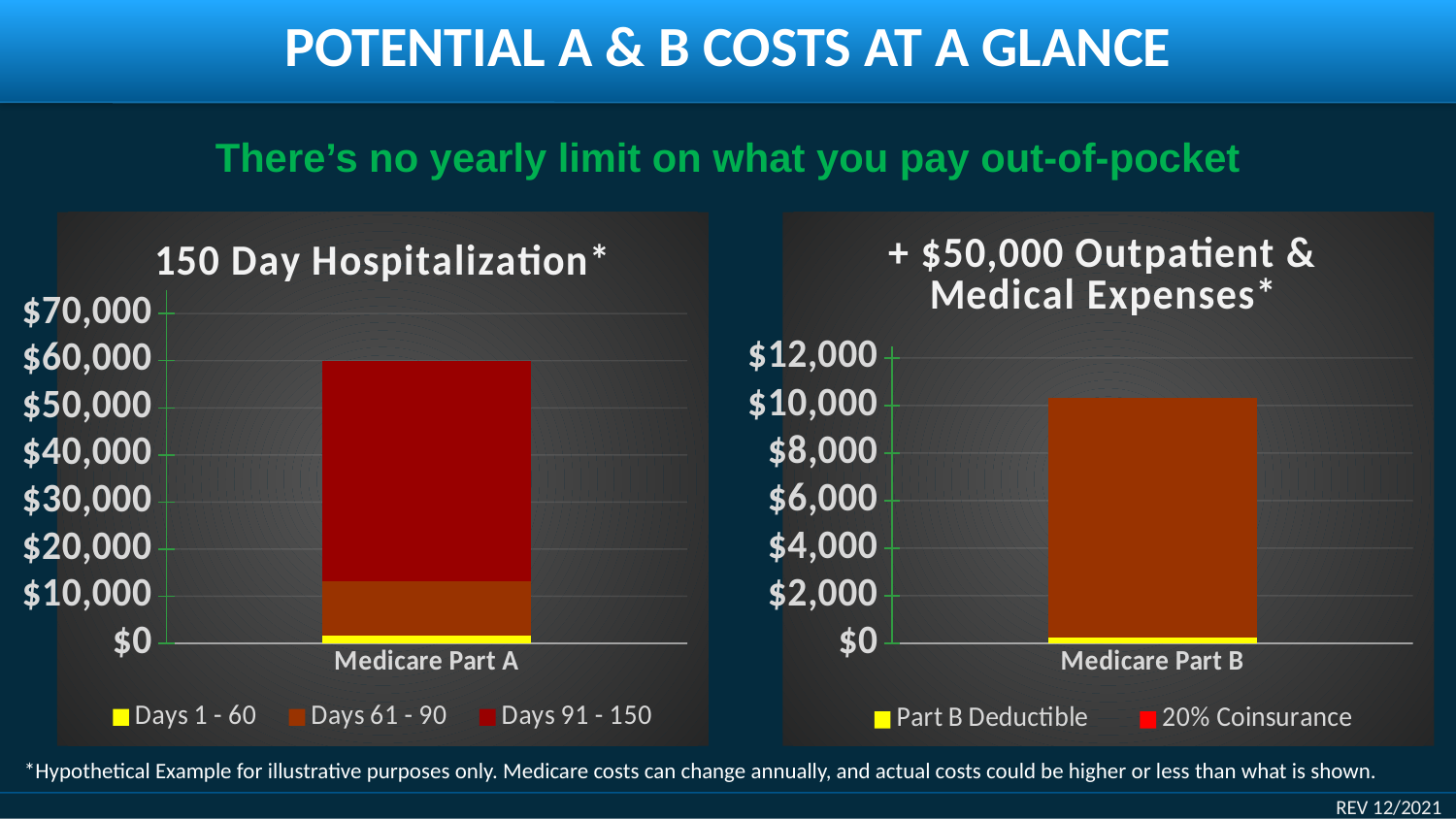
What kind of chart is the "+ $50,000 Outpatient & Medical Expenses*" chart? Stacked bar chart In the "150 Day Hospitalization*" chart, is the total height of the Medicare Part A bar greater or less than $50,000? greater What kind of chart is the "150 Day Hospitalization*" chart? Stacked bar chart In the "150 Day Hospitalization*" chart, is the Days 1 - 60 segment greater or less than $10,000? less In the "150 Day Hospitalization*" chart, which segment is larger, Days 91 - 150 or Days 61 - 90? Days 91 - 150 How many series does the legend of the "+ $50,000 Outpatient & Medical Expenses*" chart list? 2 In the "+ $50,000 Outpatient & Medical Expenses*" chart, is the 20% Coinsurance segment greater or less than $8,000? greater In the "+ $50,000 Outpatient & Medical Expenses*" chart, what is the label of the category on the x axis? Medicare Part B In the "150 Day Hospitalization*" chart, how many categories are shown on the x axis? 1 How many series does the legend of the "150 Day Hospitalization*" chart list? 3